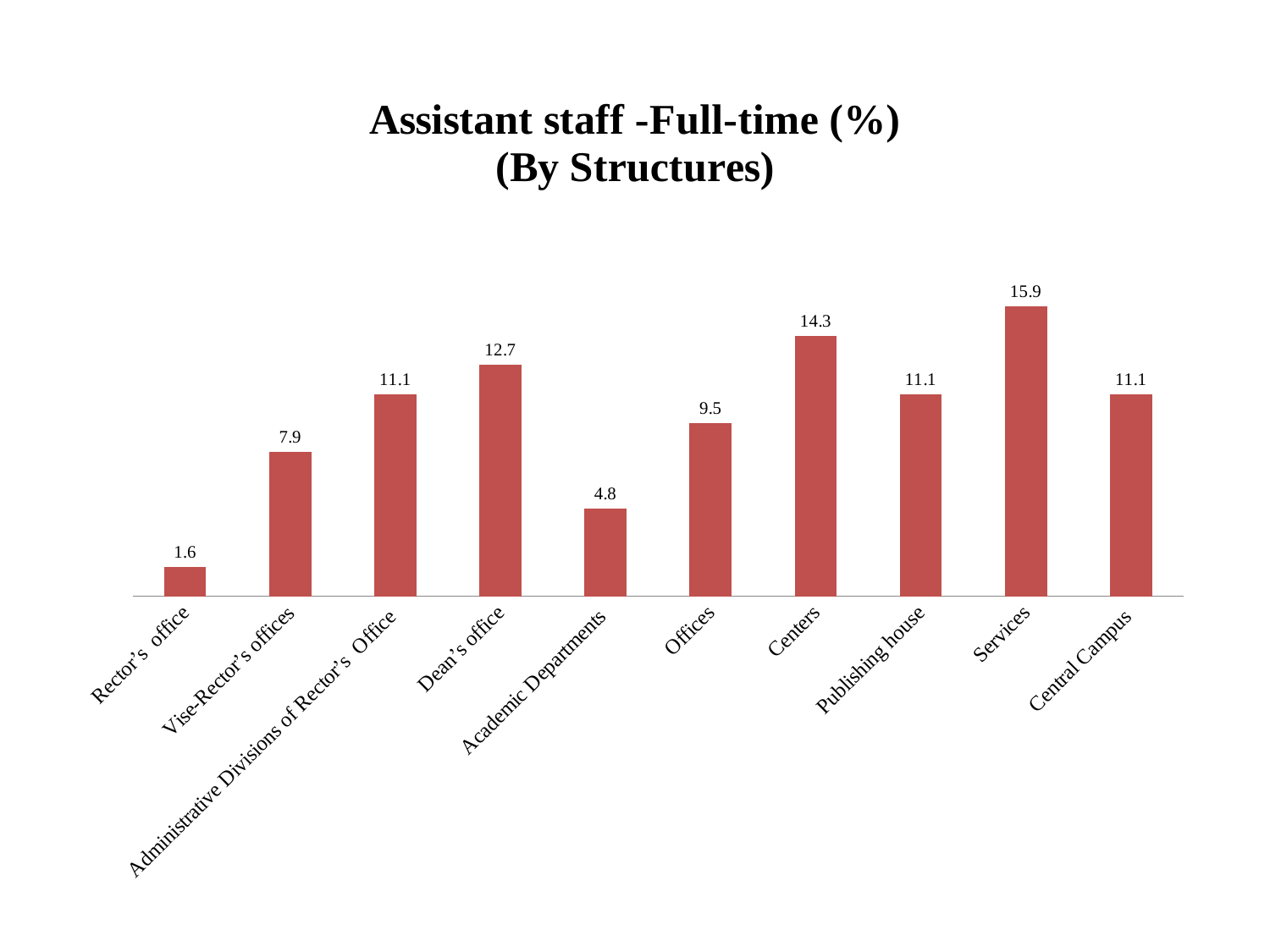
What is the value for Dean's office? 12.7 What kind of chart is shown on the slide? Bar chart What is the value for Academic Departments? 4.8 Which is larger, the value for Vise-Rector's offices or the value for Academic Departments? Vise-Rector's offices What is the value for Rector's office? 1.6 What is the difference between the values for Services and Rector's office? 14.3 What is the difference between the values for Centers and Offices? 4.8 How many categories are shown on the x axis? 10 Which category has the lowest value? Rector's office Which category has the highest value? Services What is the title of the chart? Assistant staff -Full-time (%) (By Structures) What is the value for Services? 15.9